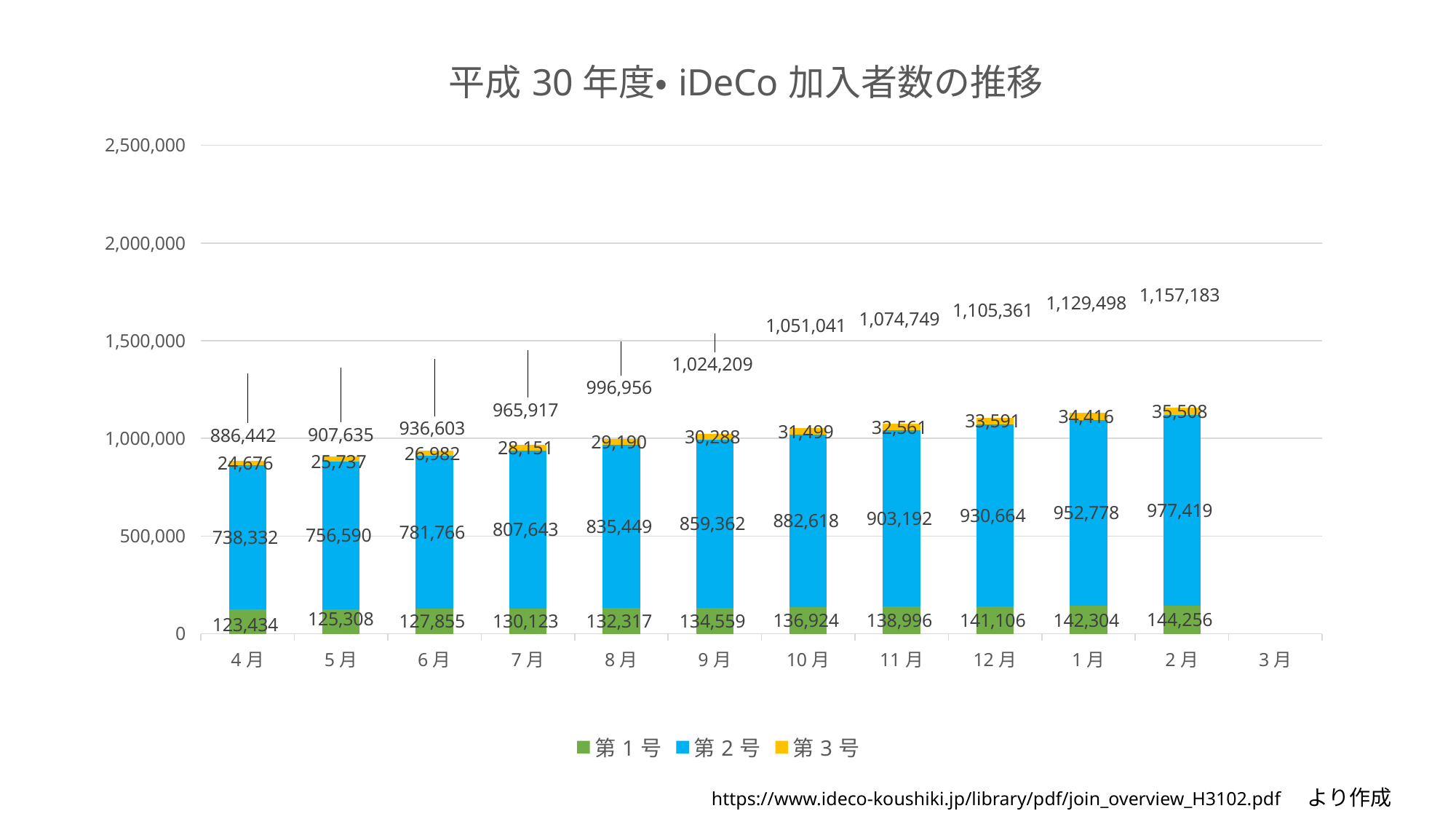
What kind of chart is shown on the slide? stacked bar chart Do the total values rise or fall from 4月 to 2月? rise What is the value for 第1号 in 2月? 144,256 Which month with data has the lowest value for 第2号? 4月 Which month has the highest total number of iDeCo subscribers? 2月 What is the difference between the 第2号 values for 2月 and 4月? 239,087 How many series does the legend list? 3 Which is larger, the 第1号 value in 12月 or the 第1号 value in 8月? 12月 Is the total for 10月 greater or less than 1,000,000? greater What is the value for 第3号 in 9月? 30,288 What is the value for 第2号 in 4月? 738,332 What is the total of the stacked bar for 1月? 1,129,498